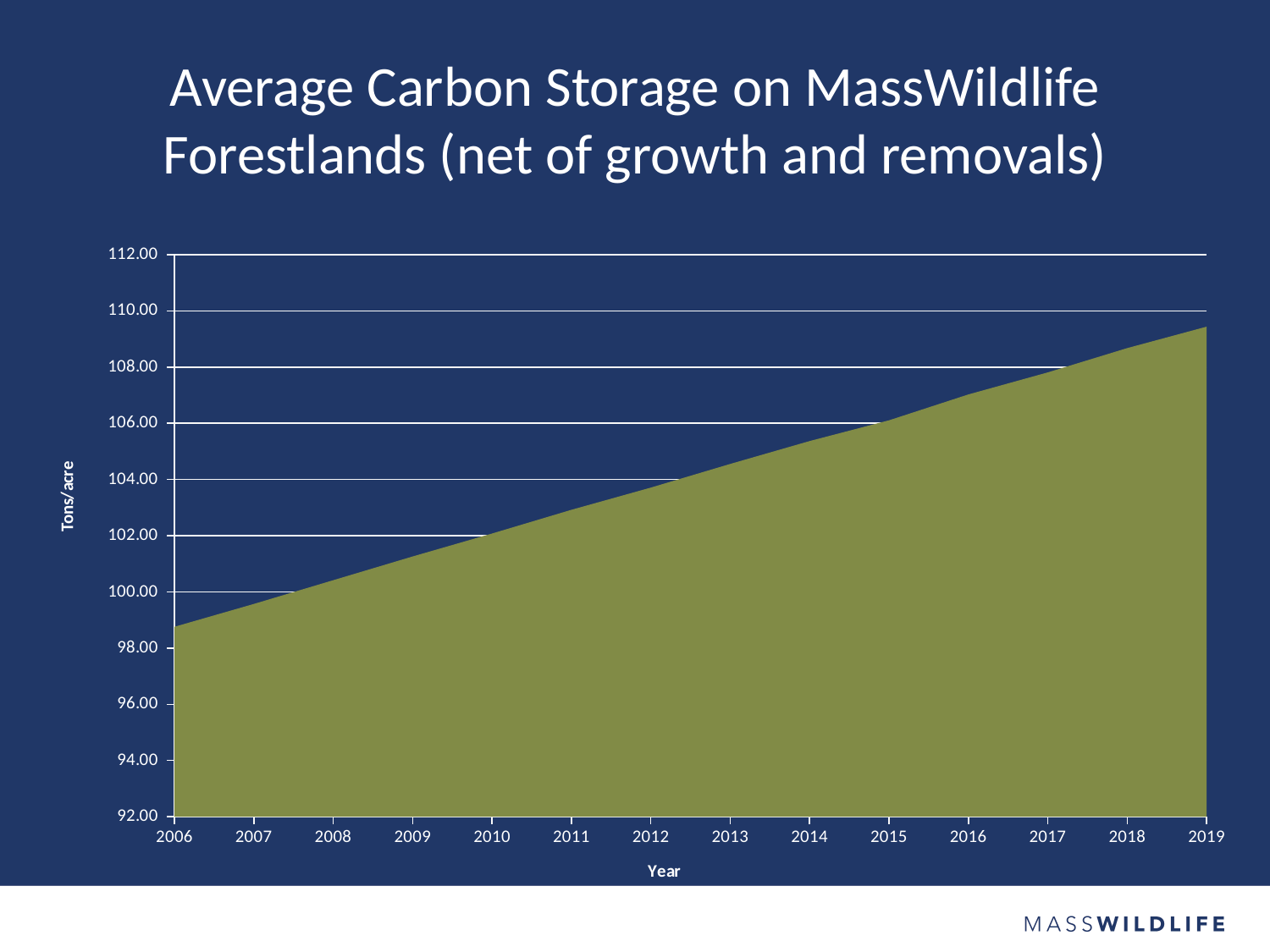
What kind of chart is shown on the slide? area chart Is the value for 2014 greater or less than 104.00? greater What is the label on the y axis? Tons/acre Do the values rise or fall from 2006 to 2019? rise Is the value for 2006 greater or less than 100.00? less Is the value for 2019 greater or less than 108.00? greater How many years are shown on the x axis? 14 Which year has the larger value, 2009 or 2016? 2016 Which year has the lowest average carbon storage? 2006 Which year has the highest average carbon storage? 2019